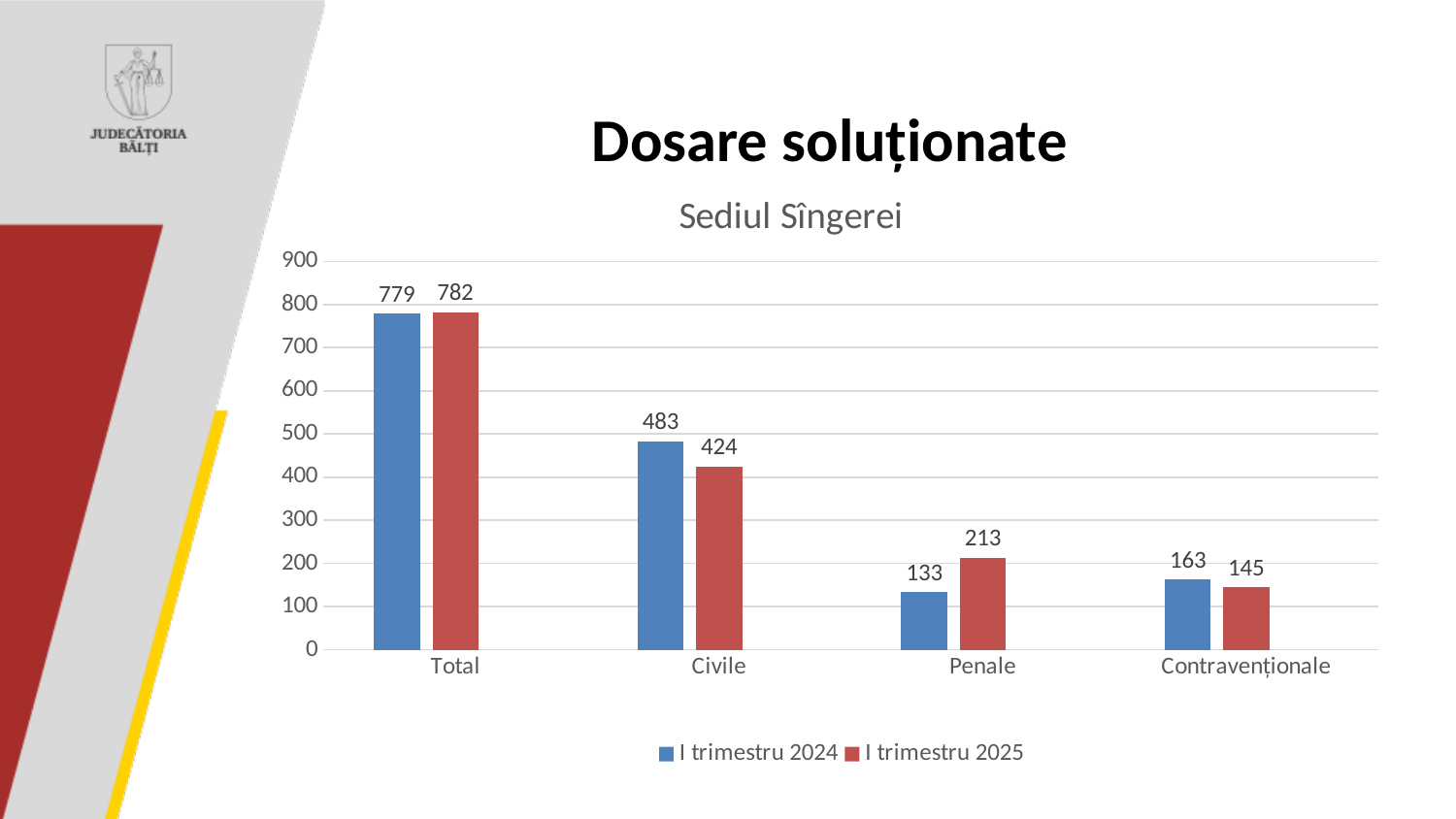
What is the value for Penale in the I trimestru 2025 series? 213 How many categories are shown on the x axis? 4 Which is larger for Penale: the I trimestru 2024 value or the I trimestru 2025 value? I trimestru 2025 What is the value for Civile in the I trimestru 2024 series? 483 How many series does the legend list? 2 What is the difference between the I trimestru 2024 and I trimestru 2025 values for Civile? 59 Which category has the highest value in the I trimestru 2025 series? Total What is the subtitle shown above the chart? Sediul Sîngerei What kind of chart is shown on the slide? Bar chart Which category has the lowest value in the I trimestru 2024 series? Penale What is the value for Total in the I trimestru 2025 series? 782 What is the value for Contravenționale in the I trimestru 2024 series? 163